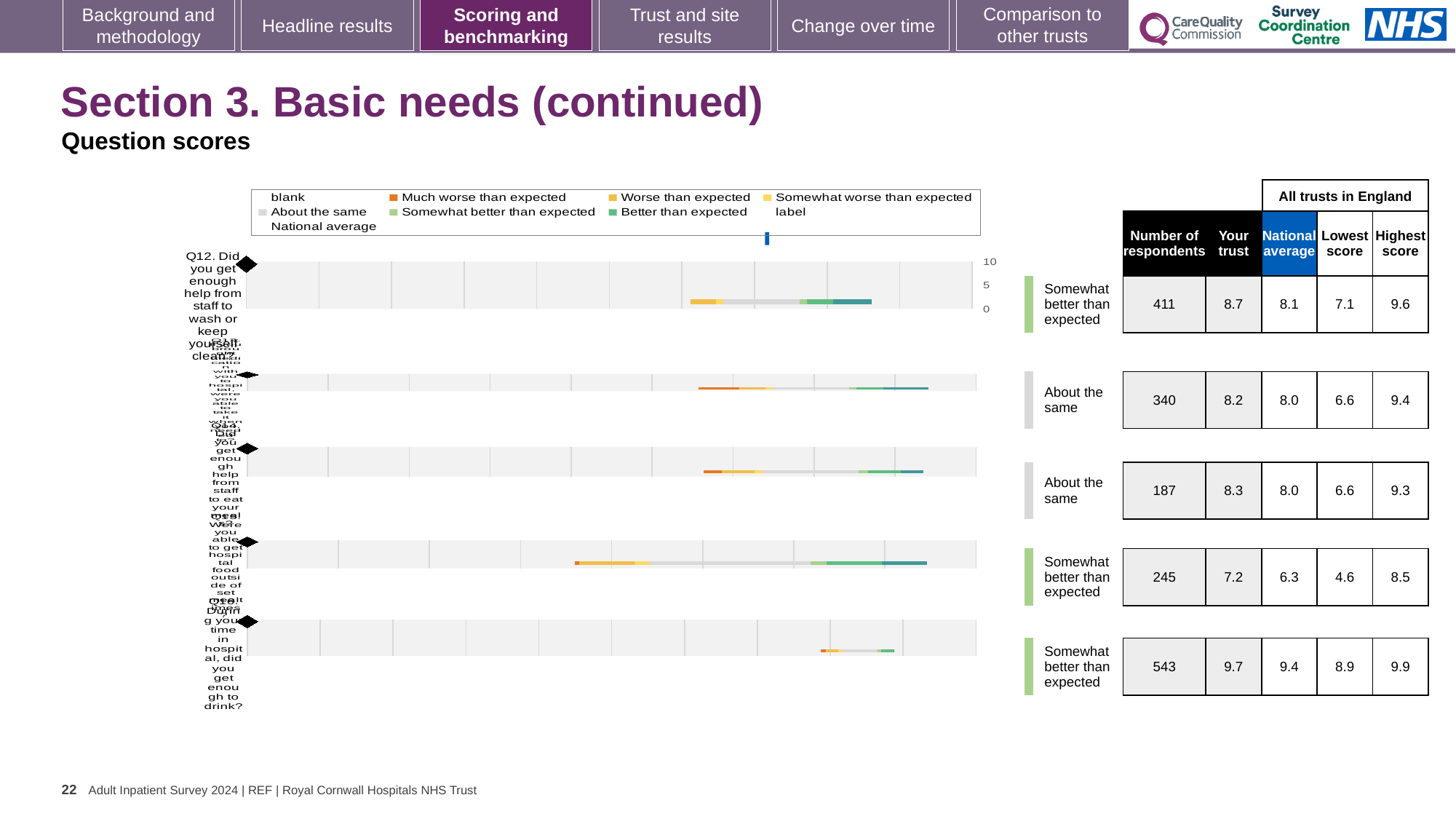
Which row has the lowest 'Your trust' score in the table beside the chart? the fourth row, 7.2 What is the 'Your trust' score for Q12 (help from staff to wash or keep yourself clean) in the table beside the chart? 8.7 What is the national average for Q12 (help from staff to wash or keep yourself clean) in the table beside the chart? 8.1 Which row has the highest 'Your trust' score in the table beside the chart? the fifth (bottom) row, 9.7 What is the difference between the 'Your trust' score and the national average for Q12 (help from staff to wash or keep yourself clean)? 0.6 How many respondents are listed for Q12 (help from staff to wash or keep yourself clean)? 411 What is the highest score across all trusts in England for the bottom row of the table? 9.9 What is the lowest score across all trusts in England for the fourth row of the table? 4.6 How many question rows (bars) does the chart show? 5 What benchmark category is shown for Q12 (help from staff to wash or keep yourself clean)? Somewhat better than expected What kind of chart is shown on the slide? bar chart For Q12 (help from staff to wash or keep yourself clean), which is larger: the 'Your trust' score or the national average? Your trust